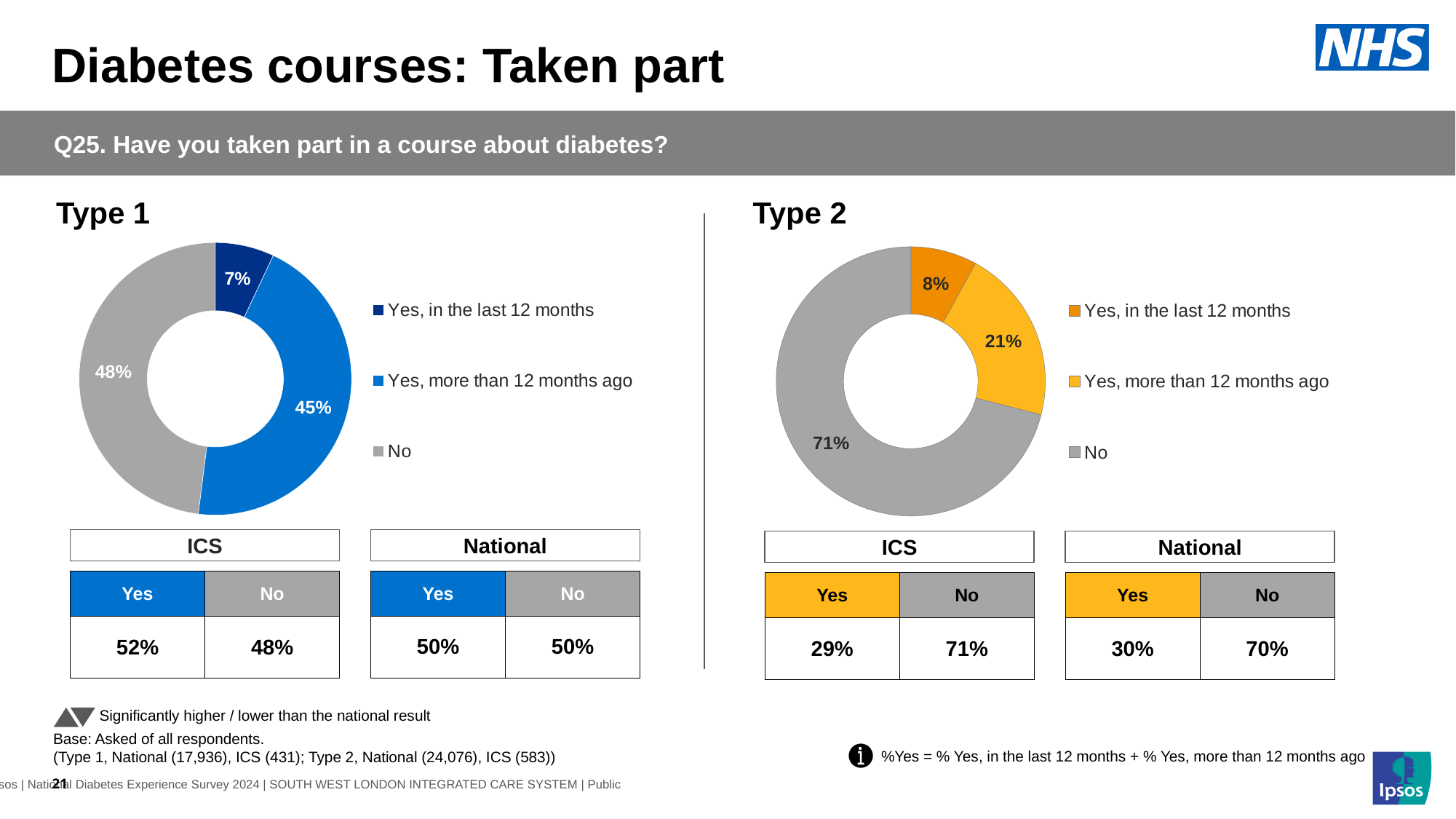
In the Type 2 chart, what colour represents 'No'? Grey How many categories does the legend of the Type 2 chart list? 3 In the Type 1 chart, what percentage of respondents said 'Yes, more than 12 months ago'? 45% In the Type 2 chart, what is the difference between the 'Yes, more than 12 months ago' share and the 'Yes, in the last 12 months' share? 13% Which is larger: the 'Yes, in the last 12 months' share in the Type 1 chart or in the Type 2 chart? Type 2 In the Type 2 chart, what percentage of respondents said 'No'? 71% What kind of chart is used for Type 1 and Type 2? Doughnut (pie) chart In the Type 2 chart, which category has the smallest share? Yes, in the last 12 months In the Type 2 chart, what percentage of respondents said 'Yes, more than 12 months ago'? 21% In the Type 1 chart, which category has the largest share? No In the Type 1 chart, what percentage of respondents said 'Yes, in the last 12 months'? 7% In the Type 1 chart, what is the difference between the 'No' share and the 'Yes, more than 12 months ago' share? 3%